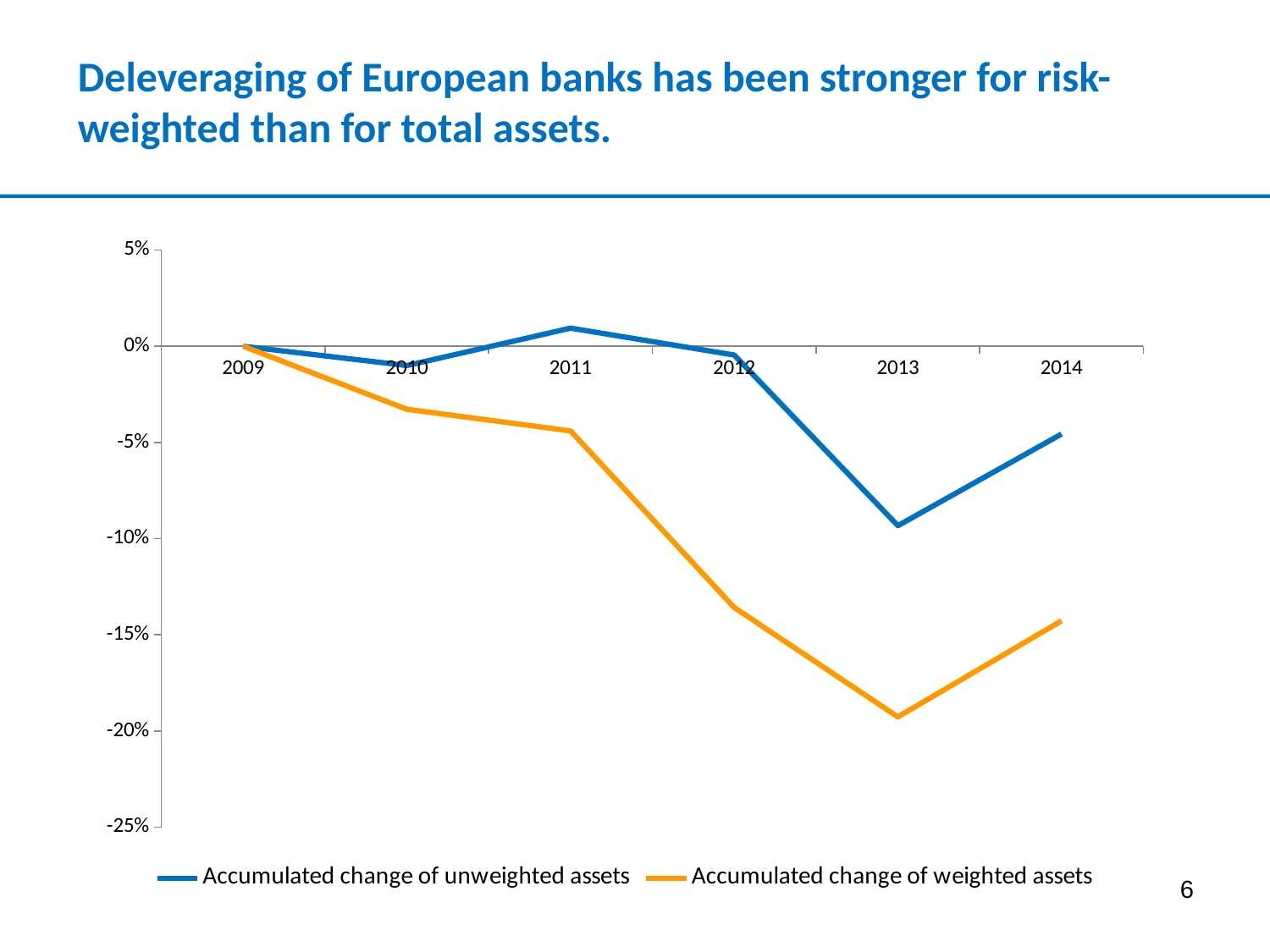
Does the accumulated change of weighted assets rise or fall from 2009 to 2013? fall How many years are plotted along the x axis? 6 Is the accumulated change of weighted assets in 2013 greater or less than -15%? less What kind of chart is shown on the slide? line chart In which year does the accumulated change of weighted assets reach its lowest point? 2013 Is the accumulated change of unweighted assets in 2013 greater or less than -10%? greater What is the accumulated change of weighted assets in 2009? 0% In 2014, which series has the higher value: accumulated change of unweighted assets or accumulated change of weighted assets? Accumulated change of unweighted assets Is the accumulated change of weighted assets in 2012 greater or less than -10%? less Which colour is used for the line showing the accumulated change of weighted assets? orange How many series does the legend list? 2 In which year does the accumulated change of unweighted assets reach its lowest point? 2013